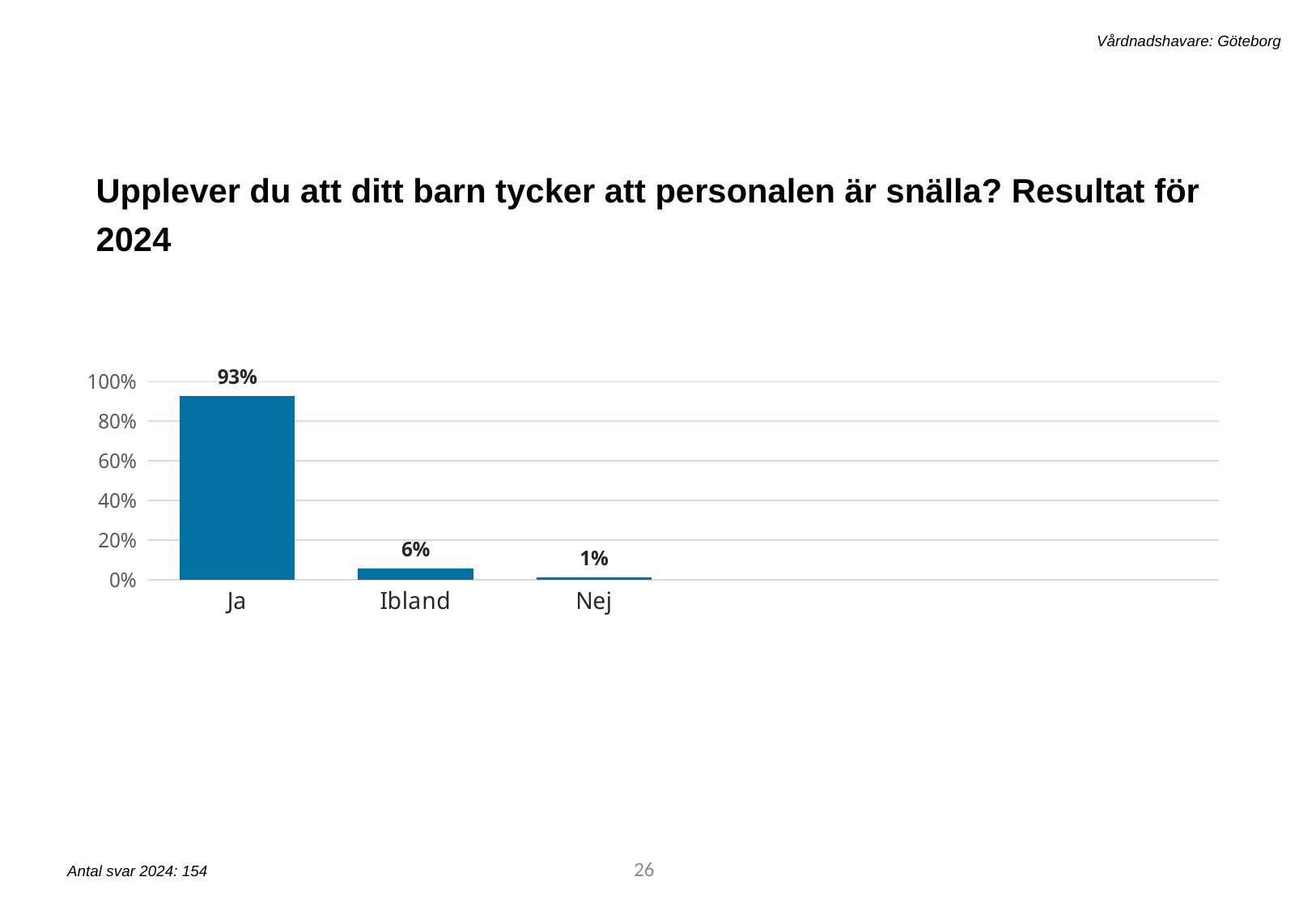
How many categories are shown on the x axis? 3 What is the difference between the values for Ja and Ibland? 87% Is the value for Ja greater or less than 80%? greater Which category has the highest value? Ja What kind of chart is shown on the slide? bar chart Which is larger, the value for Ibland or the value for Nej? Ibland Which category has the lowest value? Nej What is the difference between the values for Ibland and Nej? 5% What is the value for Ibland? 6% Do the values rise or fall from left to right along the x axis? fall What is the value for Nej? 1% What is the value for Ja? 93%